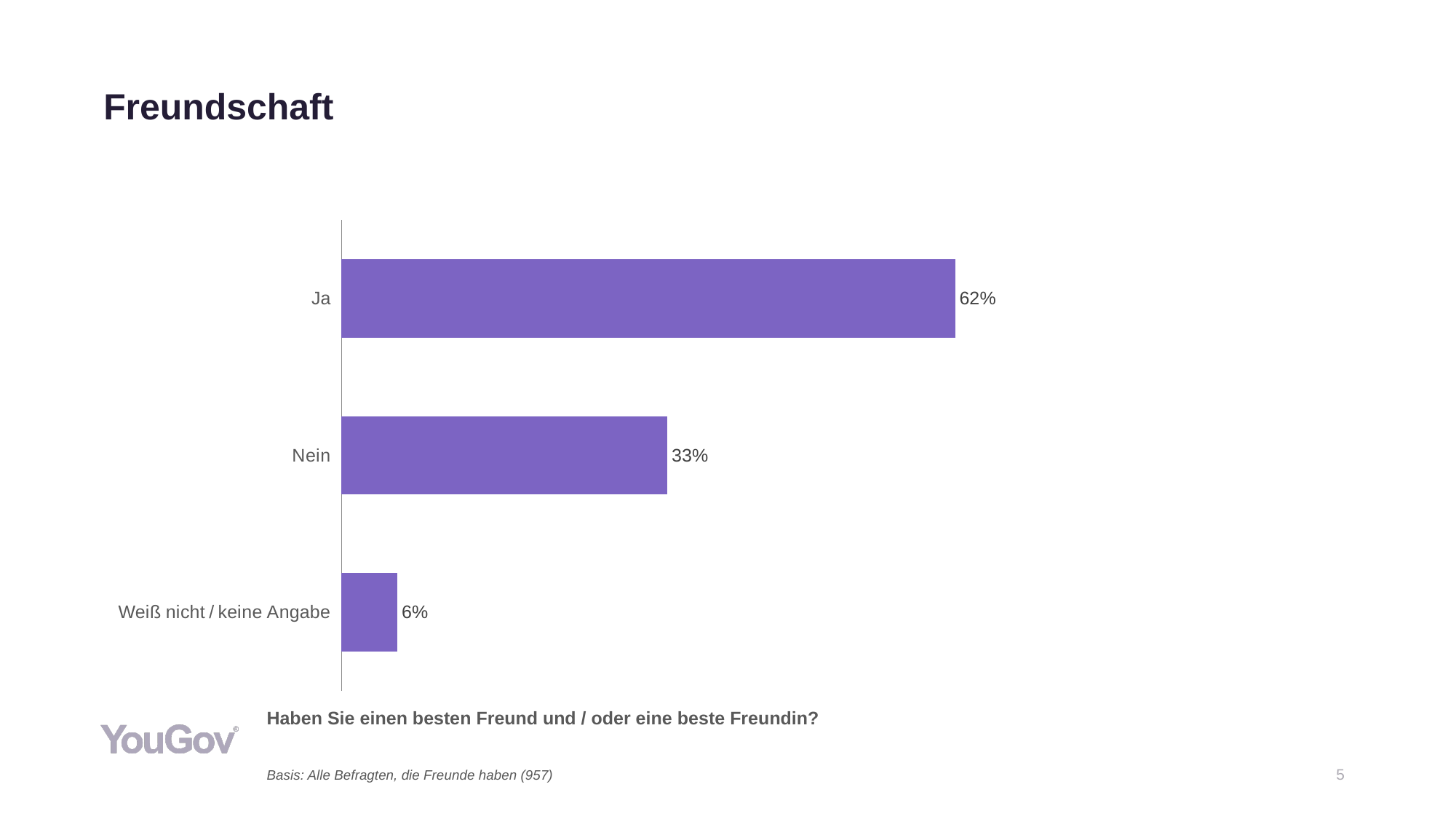
How many answer categories are shown in the chart? 3 Which answer category has the highest value? Ja What kind of chart is shown on the slide? Bar chart What percentage of respondents answered "Ja"? 62% What percentage of respondents answered "Nein"? 33% What percentage of respondents answered "Weiß nicht / keine Angabe"? 6% What is the difference in percentage points between "Nein" and "Weiß nicht / keine Angabe"? 27 percentage points What survey question is the chart based on? Haben Sie einen besten Freund und / oder eine beste Freundin? Which answer category has the lowest value? Weiß nicht / keine Angabe What is the difference in percentage points between "Ja" and "Nein"? 29 percentage points How many respondents form the basis of the chart? 957 Which is larger, the value for "Ja" or the value for "Nein"? Ja